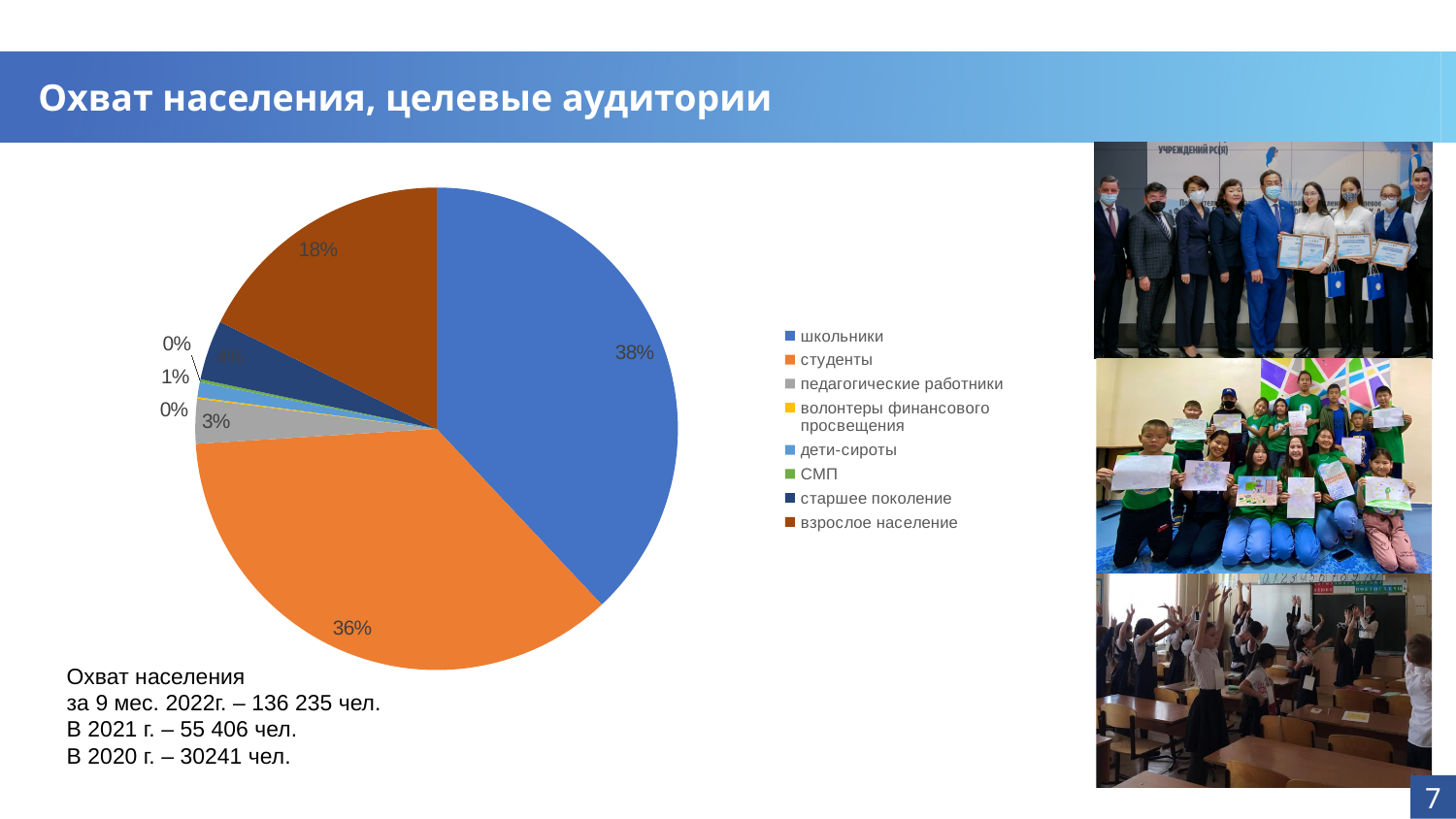
What share of the pie does the "взрослое население" slice represent? 18% What share of the pie does the "школьники" slice represent? 38% What colour is the "студенты" slice in the pie chart? orange What kind of chart is shown on the slide? pie chart Which category has the largest slice of the pie? школьники What is the difference in percentage points between the "студенты" slice and the "взрослое население" slice? 18% What share of the pie does the "педагогические работники" slice represent? 3% What is the difference in percentage points between the "школьники" slice and the "студенты" slice? 2% Which is larger, the share for "студенты" or the share for "взрослое население"? студенты How many categories does the legend of the pie chart list? 8 What share of the pie does the "дети-сироты" slice represent? 1% What share of the pie does the "студенты" slice represent? 36%